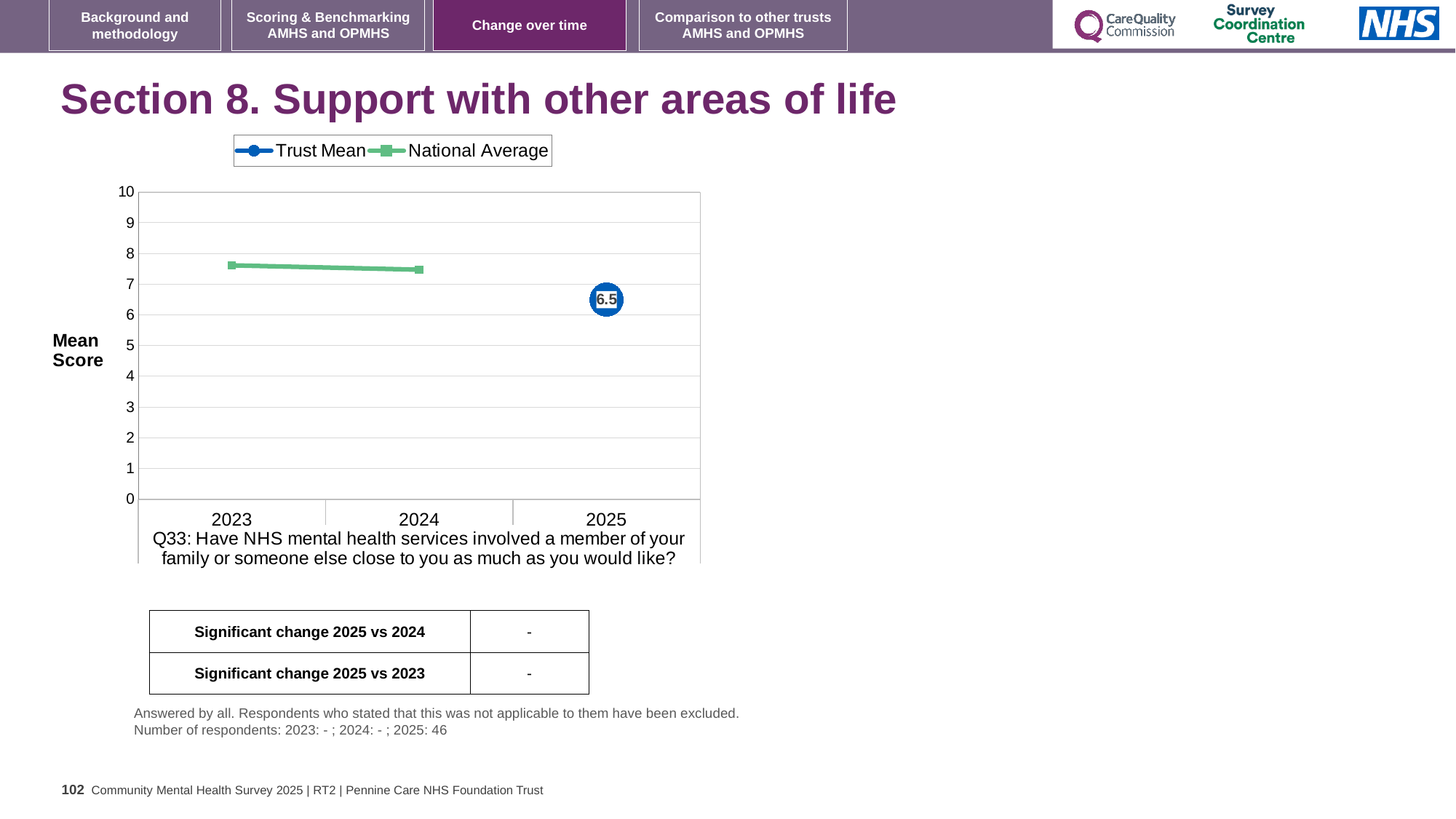
How many series does the legend list? 2 Which series is shown in blue in the legend? Trust Mean Is the Trust Mean value for 2025 greater or less than 7? less What kind of chart is shown on the slide? Line chart What is the label on the y axis of the chart? Mean Score What is the Trust Mean score for 2025? 6.5 Does the National Average rise or fall from 2023 to 2024? Fall Is the National Average value for 2024 greater or less than 8? less Is the National Average value for 2023 greater or less than 7? greater Which is larger: the National Average for 2024 or the Trust Mean for 2025? National Average for 2024 How many years are shown on the x axis? 3